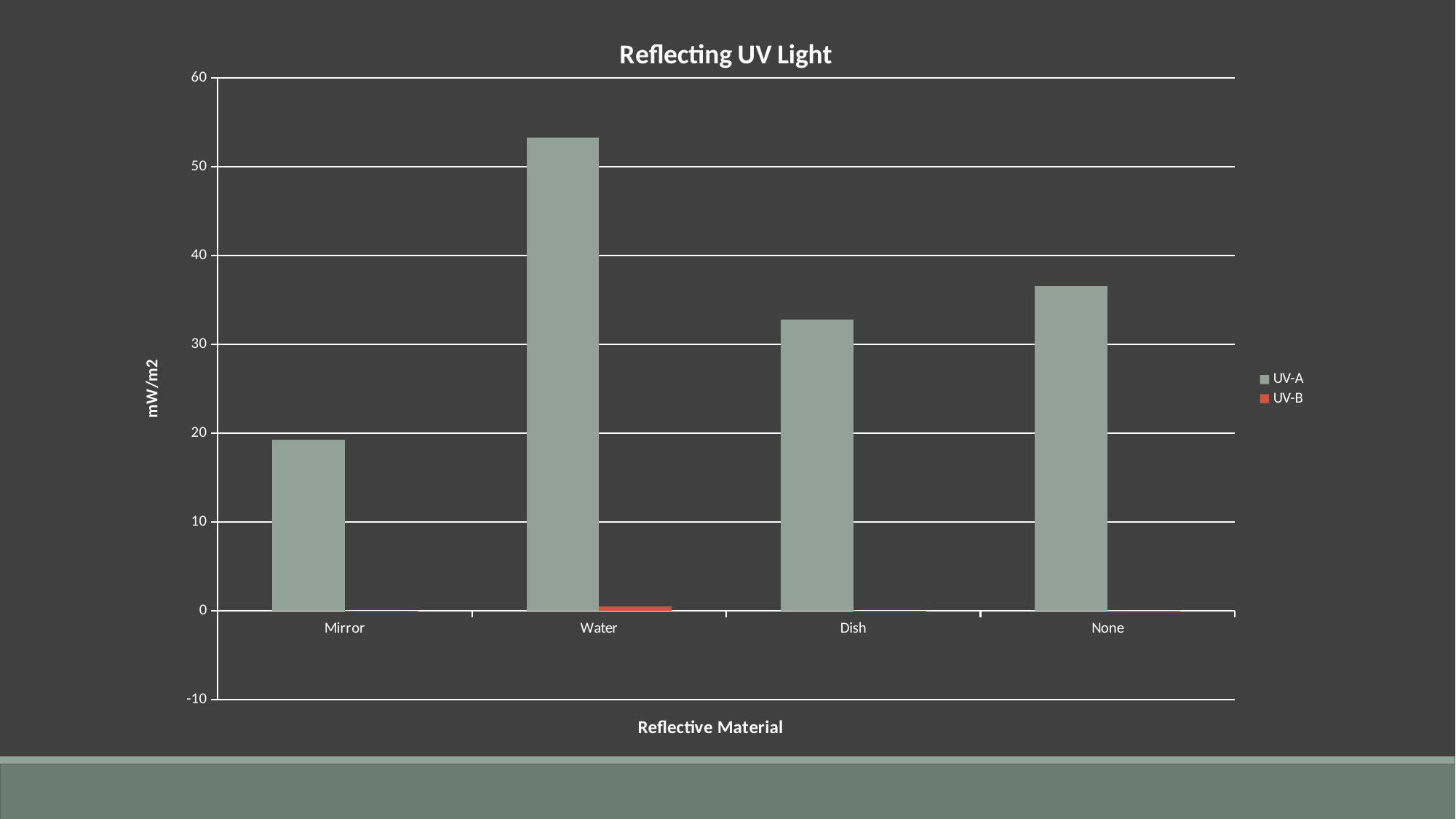
What is the title of the chart? Reflecting UV Light Which reflective material has the highest UV-A value? Water What is the label on the y axis? mW/m2 How many reflective material categories are shown on the x axis? 4 Which reflective material has the lowest UV-A value? Mirror Is the UV-A value for Dish greater or less than 30? greater What type of chart is shown on the slide? bar chart Is the UV-A value for None greater or less than 40? less Which has a larger UV-A value, None or Dish? None Is the UV-A value for Water greater or less than 50? greater How many series does the legend list? 2